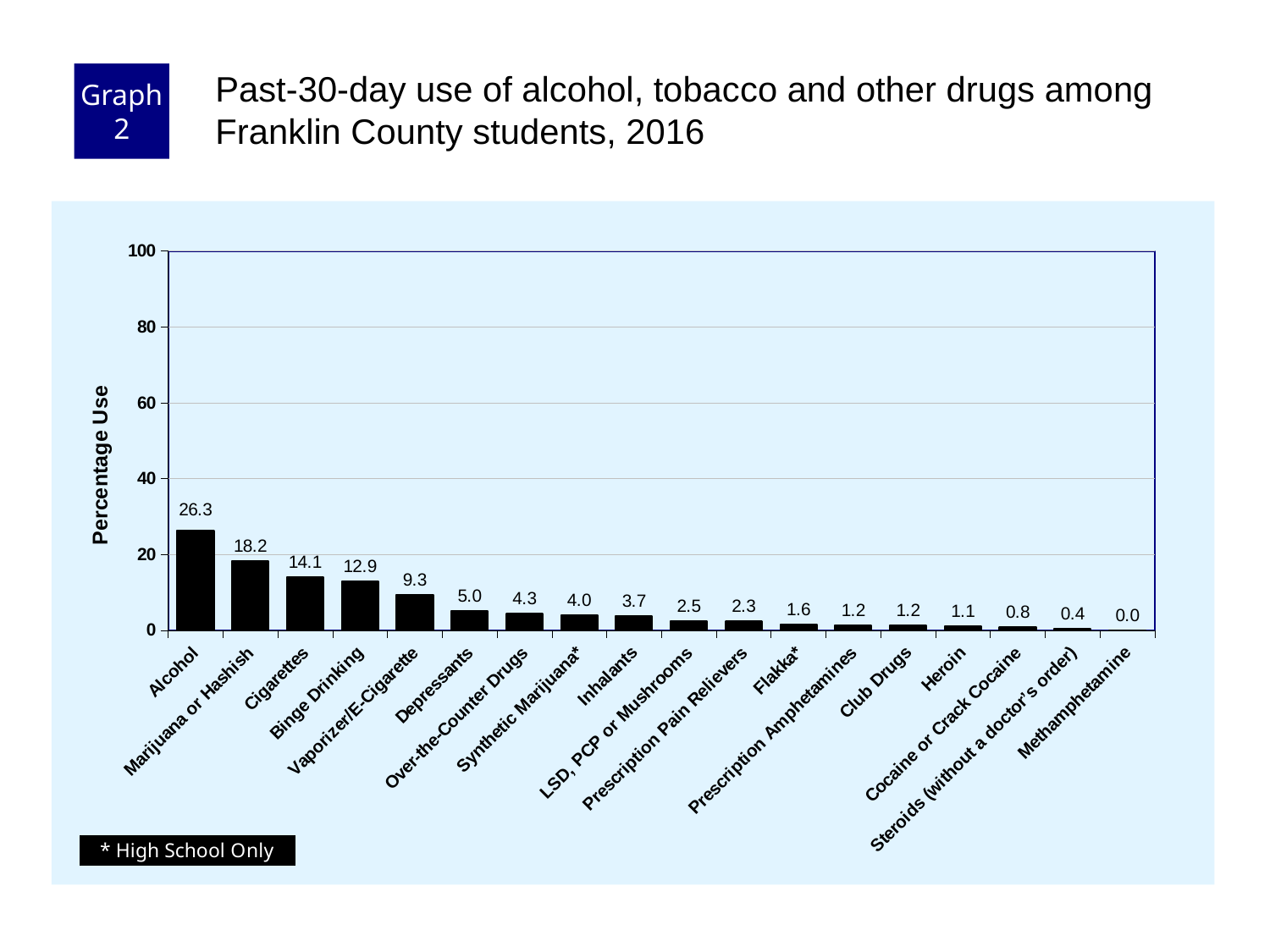
How many categories are shown on the x axis? 18 What is the value shown for Heroin? 1.1 What is the label on the y axis? Percentage Use Is the value for Alcohol greater or less than 20? greater Which category has the lowest percentage use? Methamphetamine What is the value shown for Vaporizer/E-Cigarette? 9.3 What is the difference between the values for Alcohol and Marijuana or Hashish? 8.1 What is the past-30-day use percentage for Alcohol? 26.3 What kind of chart is shown on the slide? Bar chart Which category has the highest percentage use? Alcohol What is the difference between the values for Cigarettes and Binge Drinking? 1.2 Which is larger, the value for Depressants or the value for Inhalants? Depressants